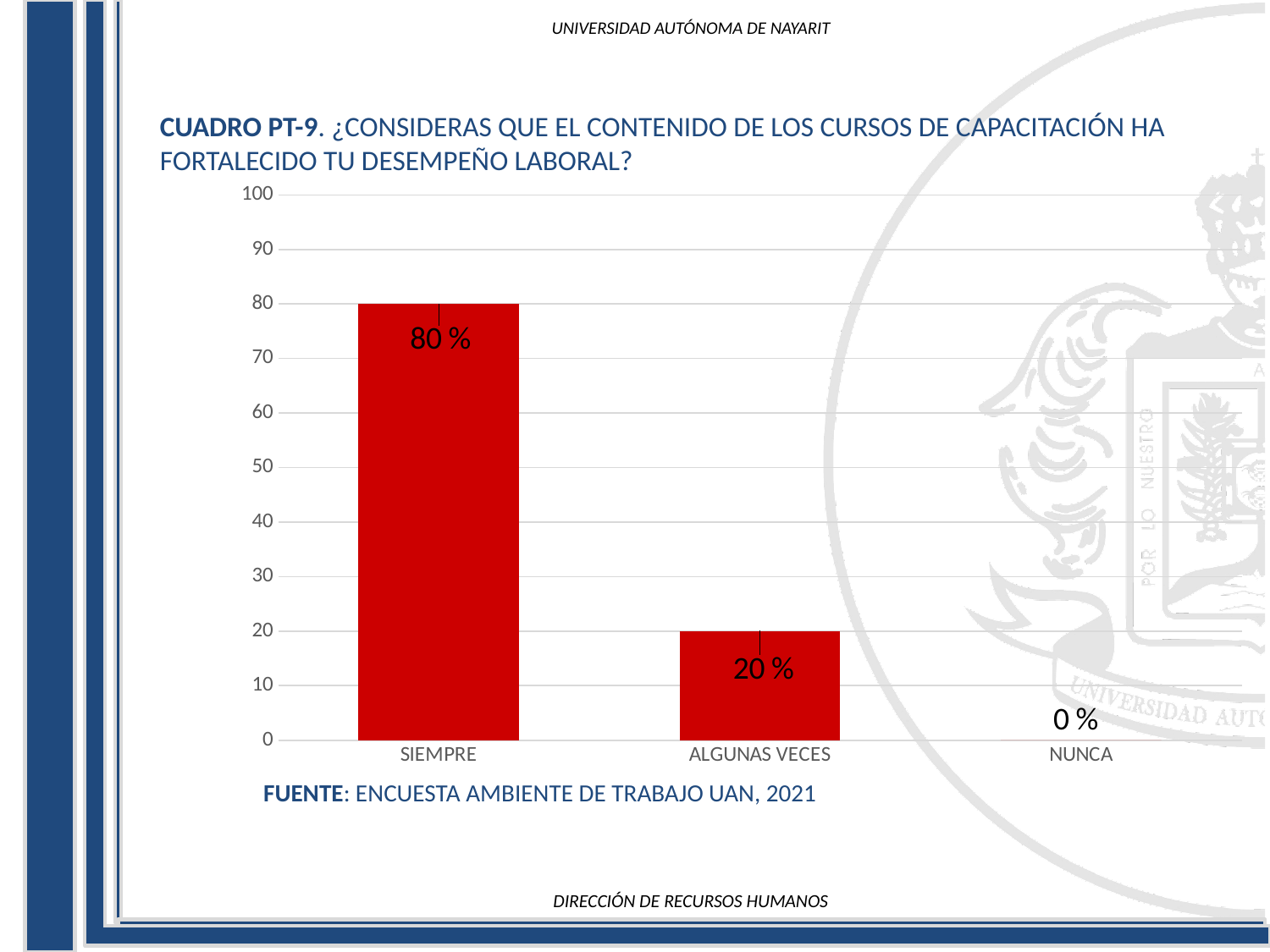
Which category has the lowest value? NUNCA What kind of chart is shown on the slide? bar chart What is the value for ALGUNAS VECES? 20 % What is the value for NUNCA? 0 % Is the value for SIEMPRE greater or less than 50? greater Do the values rise or fall from left to right along the x axis? fall What is the difference between the values for SIEMPRE and ALGUNAS VECES? 60 % What is the value for SIEMPRE? 80 % Which is larger, the value for ALGUNAS VECES or the value for NUNCA? ALGUNAS VECES What source is cited below the chart? ENCUESTA AMBIENTE DE TRABAJO UAN, 2021 How many categories are shown on the x axis? 3 Which category has the highest value? SIEMPRE